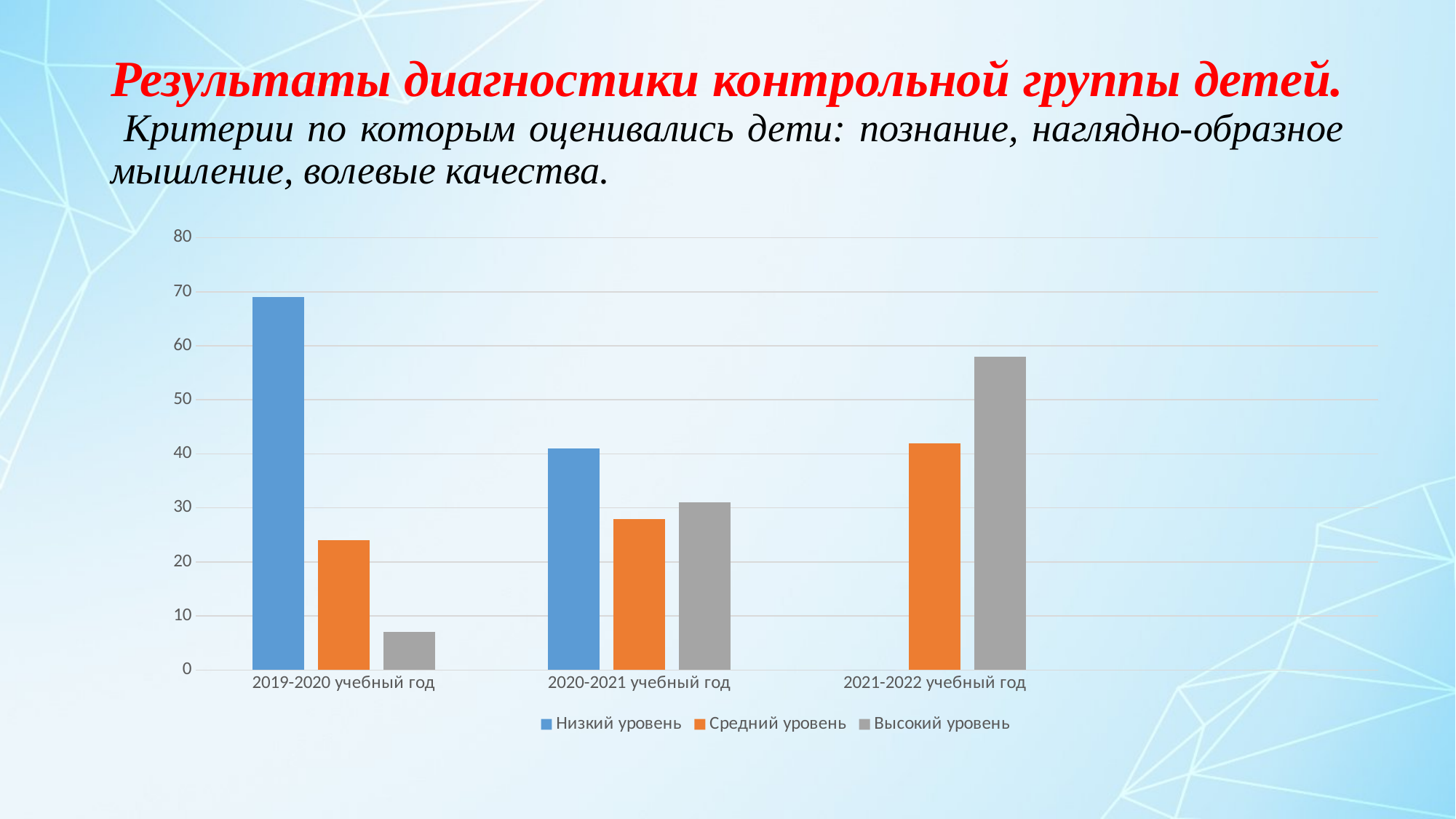
What kind of chart is shown on the slide? bar chart In which academic year is the Высокий уровень value highest? 2021-2022 учебный год Which series is represented by the blue bars? Низкий уровень Is the value for Низкий уровень in 2019-2020 учебный год greater or less than 60? greater In which academic year is the Низкий уровень value highest? 2019-2020 учебный год Does the Высокий уровень value rise or fall across the academic years from 2019-2020 to 2021-2022? rise How many series does the legend list? 3 Is the value for Высокий уровень in 2021-2022 учебный год greater or less than 50? greater Is the value for Средний уровень in 2020-2021 учебный год greater or less than 30? less How many academic-year categories are shown on the x axis? 3 Which series is represented by the grey bars? Высокий уровень